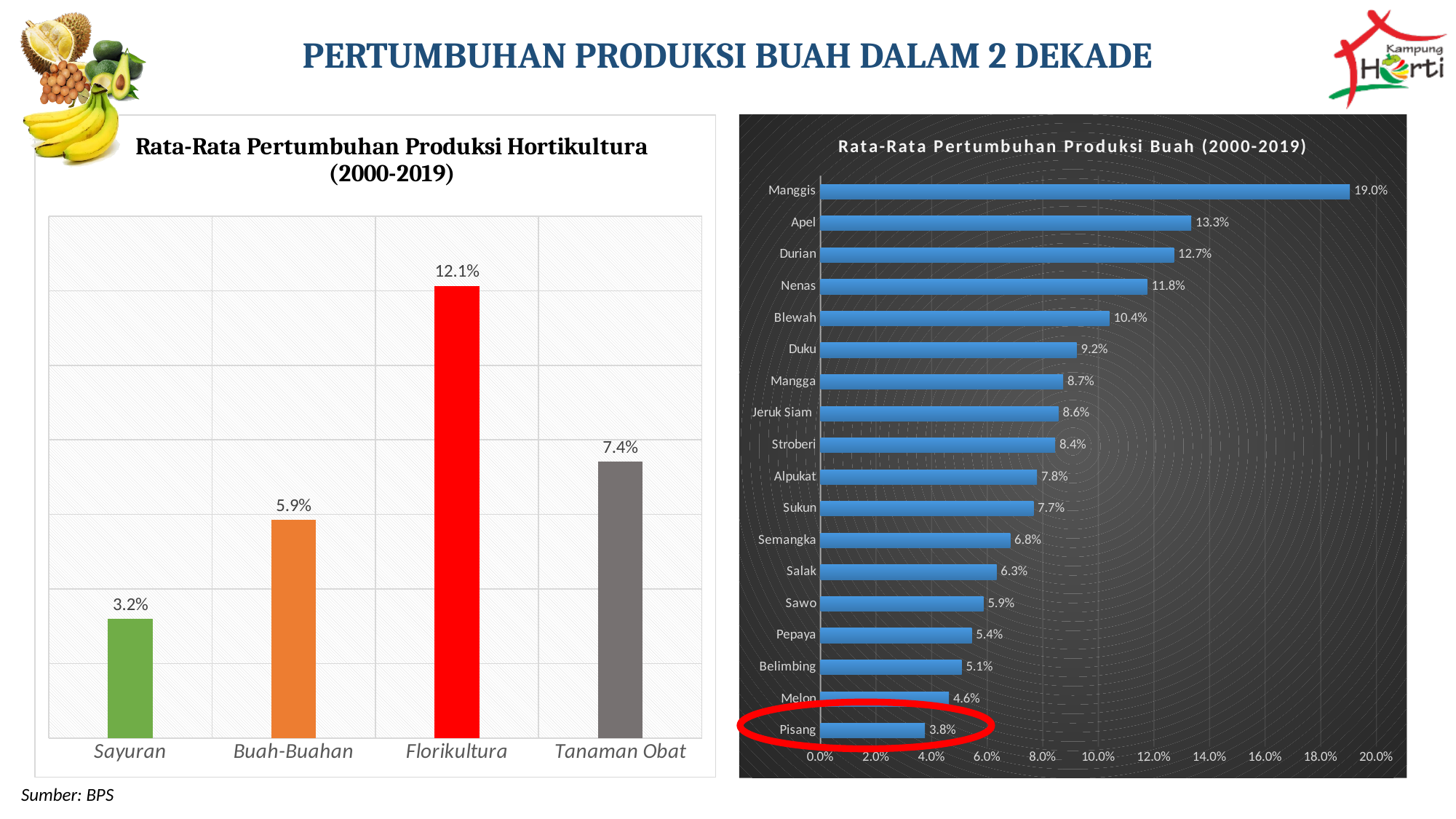
In the right chart (Rata-Rata Pertumbuhan Produksi Buah), what is the difference between Manggis and Apel? 5.7% In the right chart (Rata-Rata Pertumbuhan Produksi Buah), how many fruits are listed? 18 In the left chart (Rata-Rata Pertumbuhan Produksi Hortikultura), what kind of chart is it? Bar chart In the left chart (Rata-Rata Pertumbuhan Produksi Hortikultura), which category has the lowest value? Sayuran In the right chart (Rata-Rata Pertumbuhan Produksi Buah), what is the value for Durian? 12.7% In the left chart (Rata-Rata Pertumbuhan Produksi Hortikultura), what is the difference between Tanaman Obat and Buah-Buahan? 1.5% In the right chart (Rata-Rata Pertumbuhan Produksi Buah), which fruit is circled in red? Pisang In the left chart (Rata-Rata Pertumbuhan Produksi Hortikultura), what is the value for Florikultura? 12.1% In the right chart (Rata-Rata Pertumbuhan Produksi Buah), which fruit has the highest value? Manggis In the left chart (Rata-Rata Pertumbuhan Produksi Hortikultura), how many categories are shown? 4 In the right chart (Rata-Rata Pertumbuhan Produksi Buah), which fruit has the lowest value? Pisang In the right chart (Rata-Rata Pertumbuhan Produksi Buah), which is larger, Semangka or Salak? Semangka